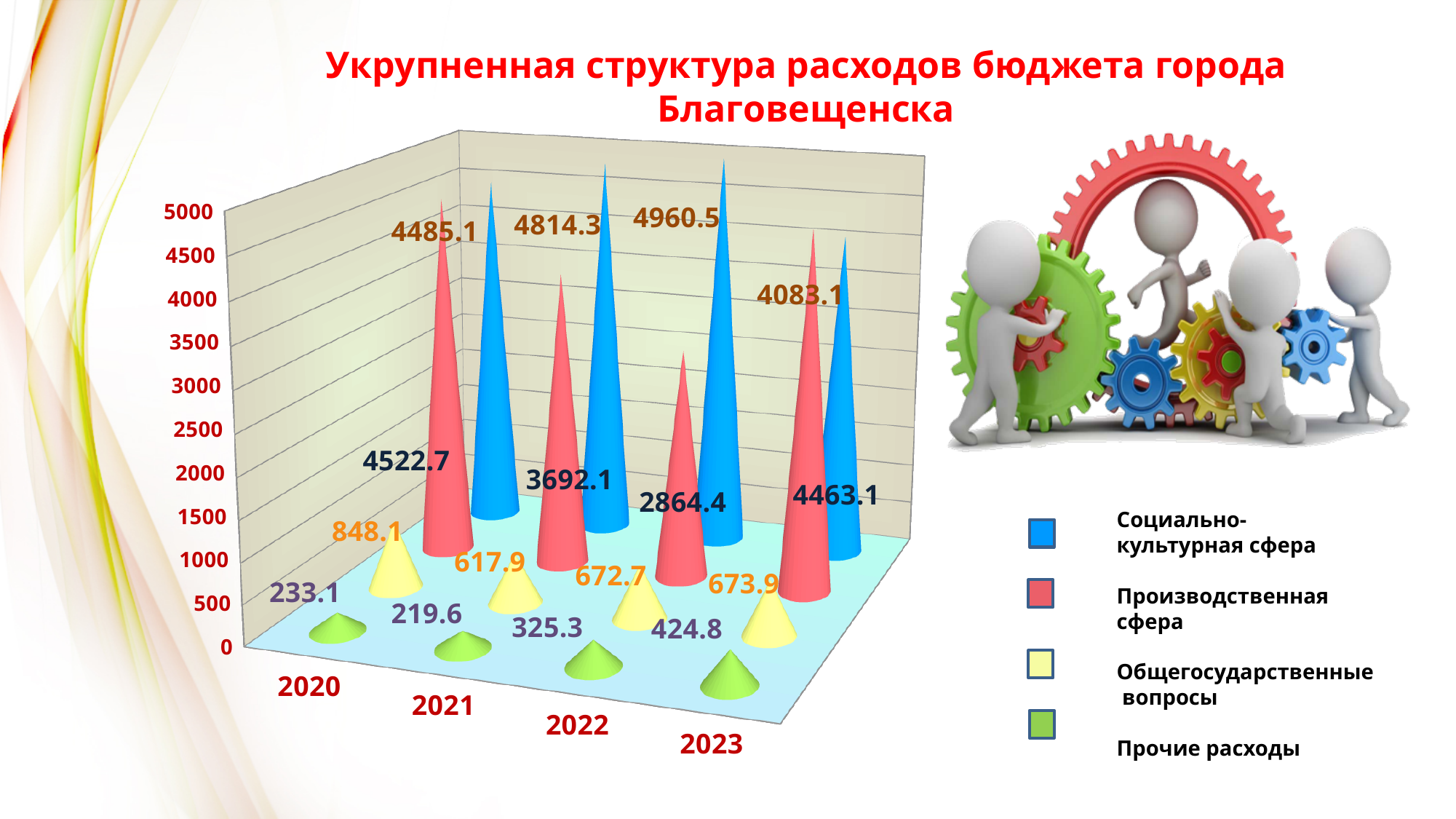
What is the difference between the Социально-культурная сфера value in 2022 and in 2023? 877.4 What is the value for Производственная сфера in 2020? 4522.7 Which colour represents Общегосударственные вопросы in the legend? yellow In which year is the value for Производственная сфера the lowest? 2022 What is the value for Прочие расходы in 2023? 424.8 What is the value for Социально-культурная сфера in 2022? 4960.5 How many series does the legend list? 4 What is the value for Общегосударственные вопросы in 2021? 617.9 How many years are shown on the x axis? 4 Which is larger in 2023: Социально-культурная сфера or Производственная сфера? Производственная сфера In which year is the value for Социально-культурная сфера the highest? 2022 Does the value for Прочие расходы rise or fall from 2021 to 2023? rise